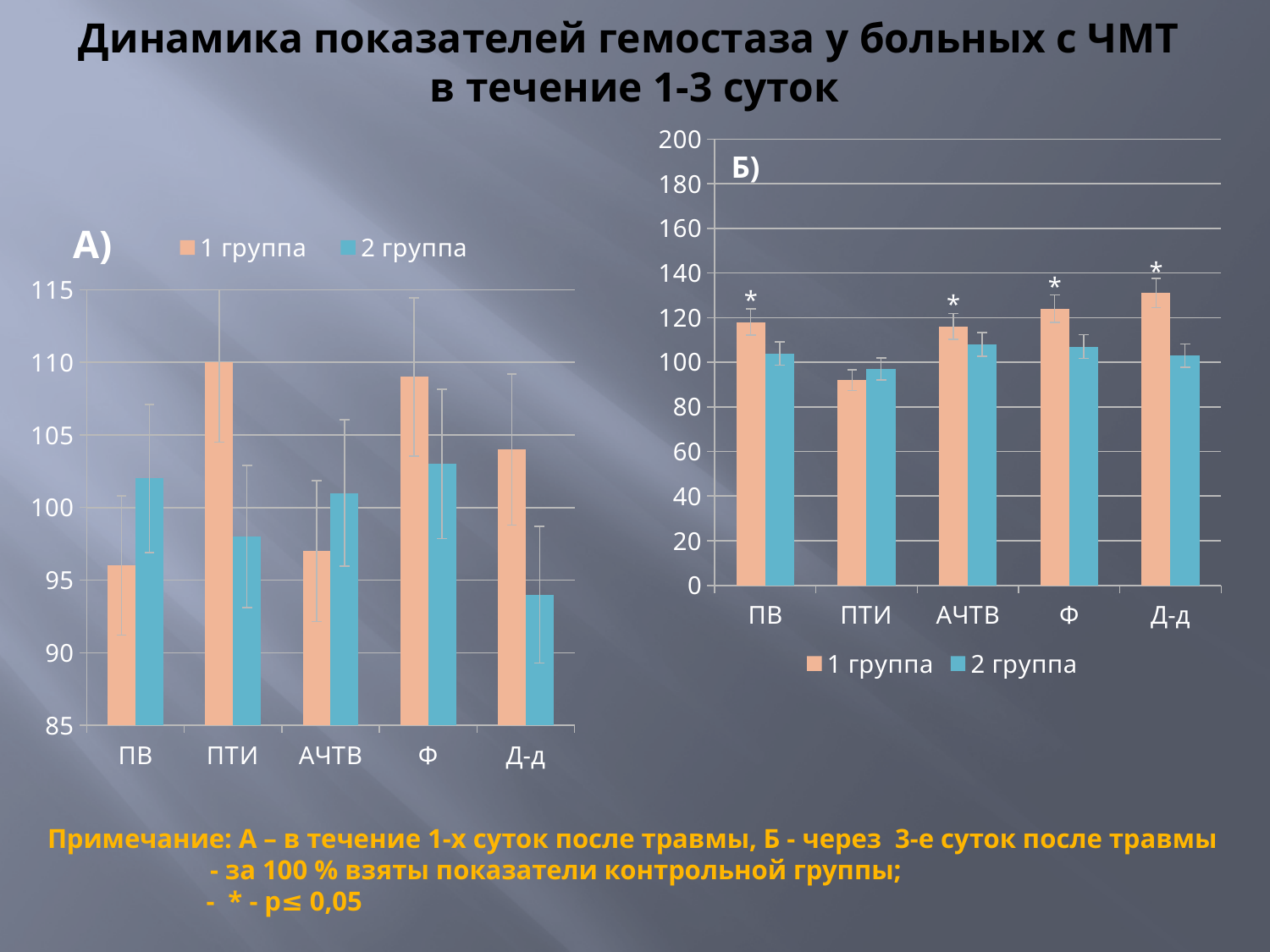
In chart Б), is the value for ПТИ in 1 группа greater or less than 100? less In chart А), is the value for Д-д in 2 группа greater or less than 95? less What kind of chart is chart А)? bar chart In chart Б), which category has the lowest value for 1 группа? ПТИ How many categories are shown on the x axis of chart Б)? 5 What are the two legend entries in chart Б)? 1 группа, 2 группа In chart Б), which category has the highest value for 1 группа? Д-д In chart А), is the value for ПТИ in 1 группа greater or less than 105? greater In chart А), which is larger for ПВ: 1 группа or 2 группа? 2 группа How many series does the legend of chart А) list? 2 In chart Б), which is larger for Ф: 1 группа or 2 группа? 1 группа